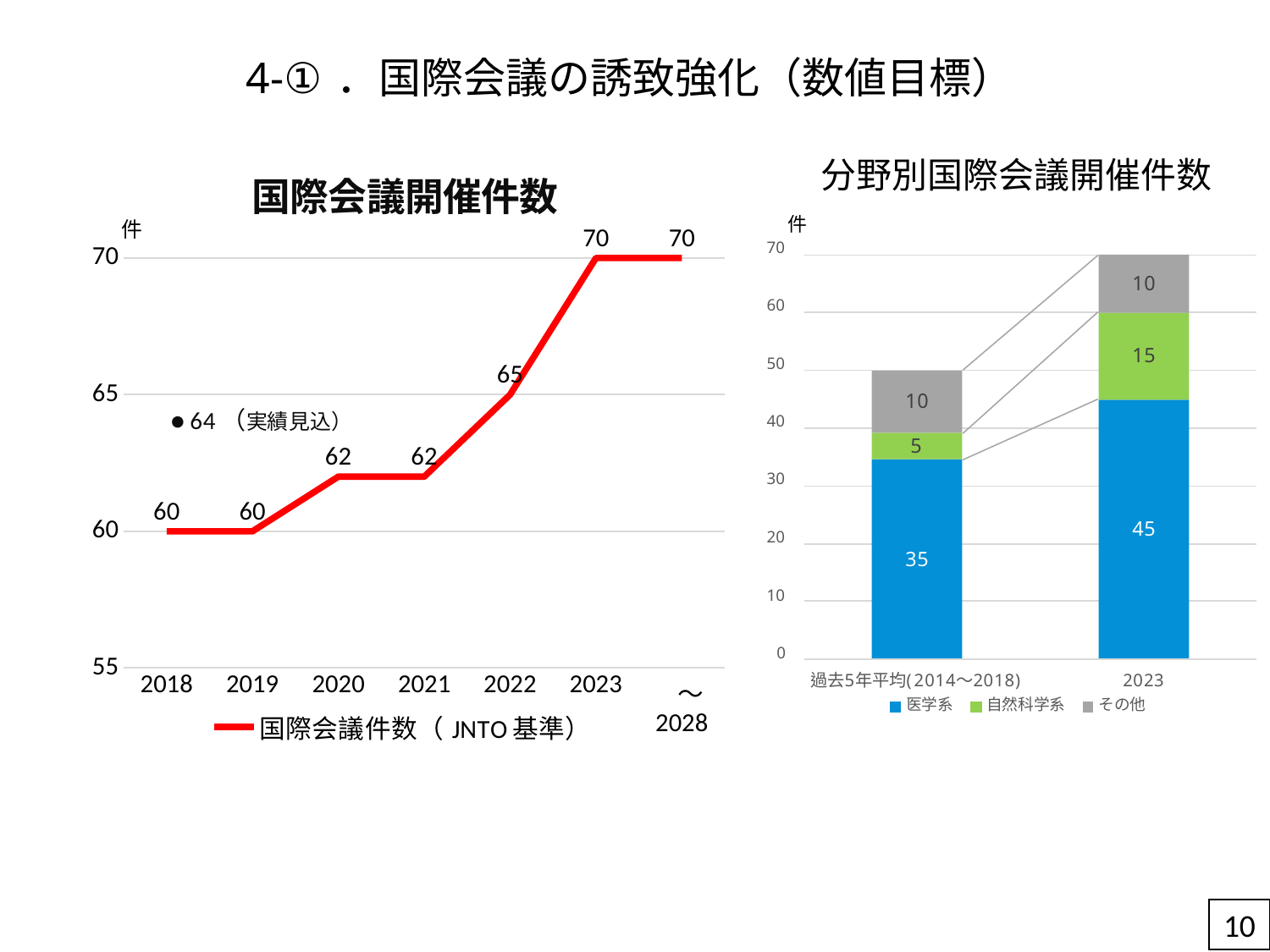
In the chart titled 国際会議開催件数, what is the value for 2022? 65 In the chart titled 分野別国際会議開催件数, how many series does the legend list? 3 In the chart titled 国際会議開催件数, what kind of chart is it? line chart In the chart titled 分野別国際会議開催件数, what is the total of the stacked bar for 過去5年平均(2014〜2018)? 50 In the chart titled 国際会議開催件数, what is the value for 2020? 62 In the chart titled 国際会議開催件数, what is the difference between the values for 2023 and 2018? 10 In the chart titled 分野別国際会議開催件数, which is larger, 自然科学系 for 2023 or 自然科学系 for 過去5年平均(2014〜2018)? 2023 In the chart titled 国際会議開催件数, what is the value of the dot labelled 実績見込? 64 In the chart titled 国際会議開催件数, do the values generally rise or fall from 2018 to 2023? rise In the chart titled 分野別国際会議開催件数, what is the total of the stacked bar for 2023? 70 In the chart titled 分野別国際会議開催件数, what is the value of 自然科学系 for 過去5年平均(2014〜2018)? 5 In the chart titled 分野別国際会議開催件数, what is the value of 医学系 for 2023? 45